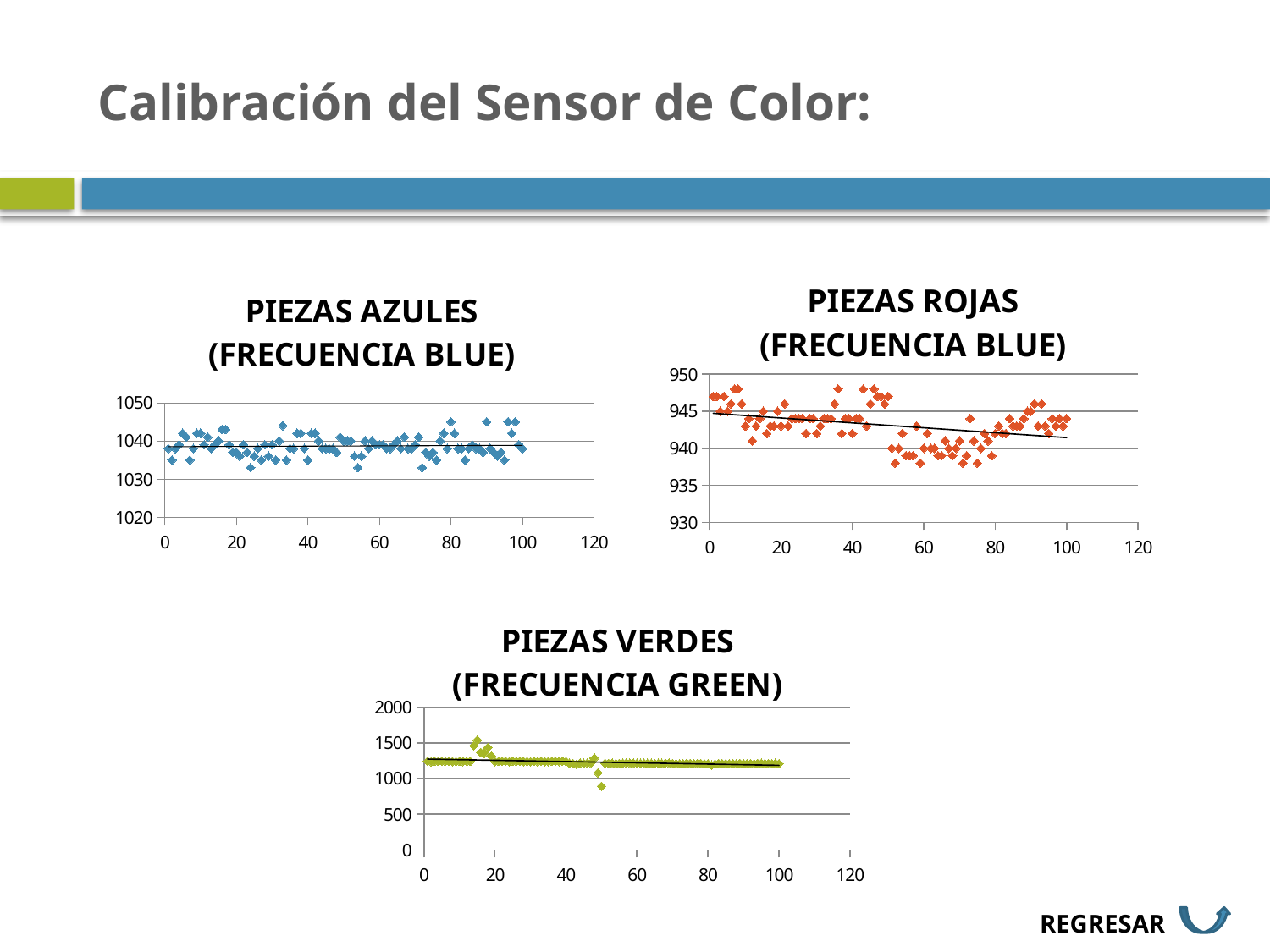
In the 'PIEZAS VERDES (FRECUENCIA GREEN)' chart, is the lowest point (near x = 50) greater or less than 1000? less In the 'PIEZAS ROJAS (FRECUENCIA BLUE)' chart, are all the plotted points greater or less than 950? less How many charts are shown on the slide? 3 In the 'PIEZAS ROJAS (FRECUENCIA BLUE)' chart, does the trend line rise or fall along the x axis? fall What is the title of the chart at the bottom of the slide? PIEZAS VERDES (FRECUENCIA GREEN) In the 'PIEZAS VERDES (FRECUENCIA GREEN)' chart, is the highest point (near x = 15) greater or less than 1500? greater What is the highest value shown on the y axis of the 'PIEZAS VERDES (FRECUENCIA GREEN)' chart? 2000 What kind of chart is 'PIEZAS AZULES (FRECUENCIA BLUE)'? scatter chart In the 'PIEZAS ROJAS (FRECUENCIA BLUE)' chart, are the points around x = 40 higher or lower than the points around x = 60? higher In the 'PIEZAS VERDES (FRECUENCIA GREEN)' chart, does the trend line rise or fall along the x axis? fall